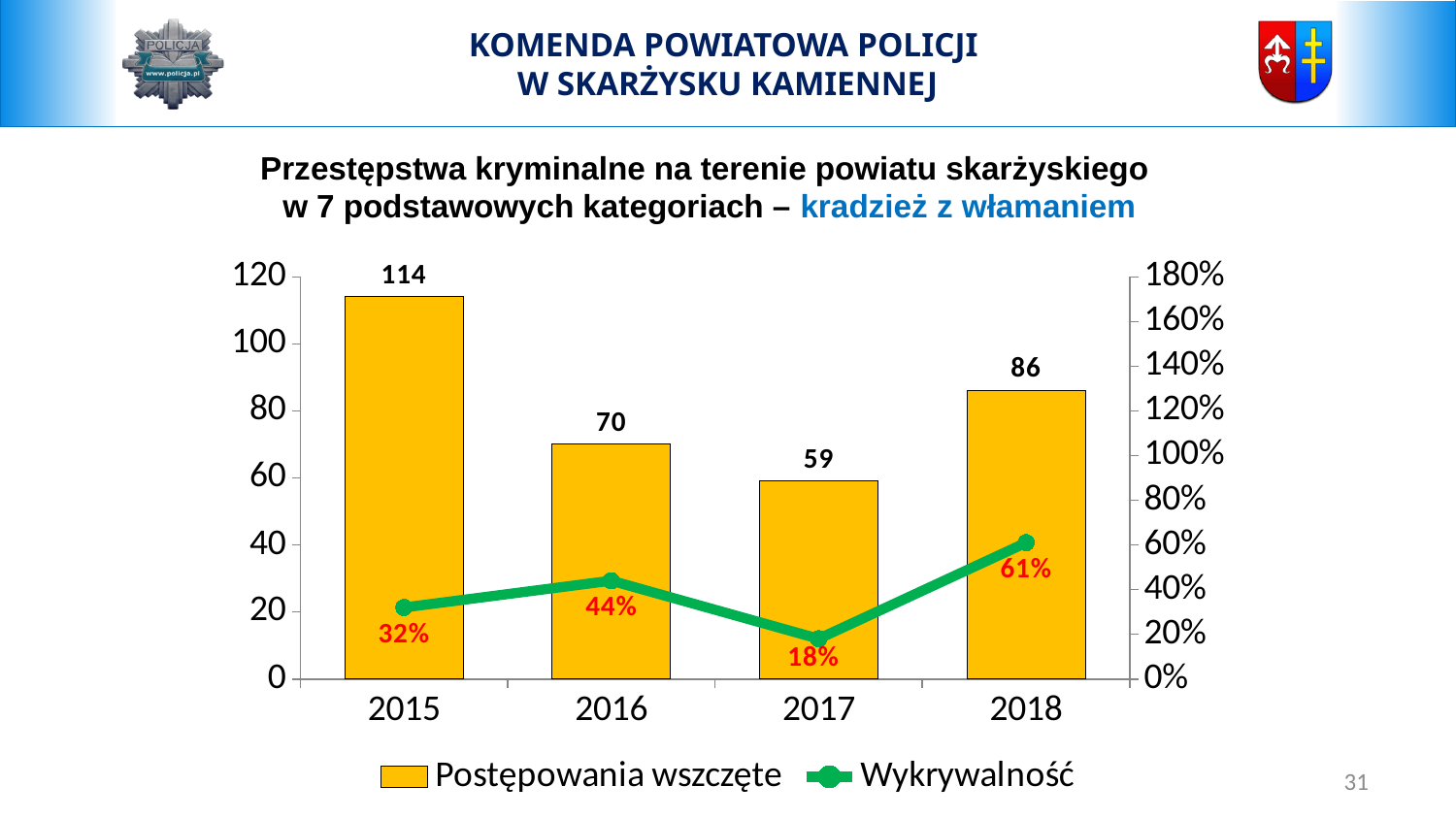
What is the value of Postępowania wszczęte for 2015? 114 What is the difference in Postępowania wszczęte between 2015 and 2016? 44 How many years are shown on the x axis? 4 What colour are the Postępowania wszczęte bars? yellow What kind of chart is used for the Postępowania wszczęte series? bar chart Which year has the highest value of Postępowania wszczęte? 2015 Did Postępowania wszczęte rise or fall from 2017 to 2018? rise Which year has the lowest Wykrywalność? 2017 How many series does the legend list? 2 Which year has the higher Wykrywalność, 2016 or 2018? 2018 What is the value of Postępowania wszczęte for 2018? 86 What is the Wykrywalność value for 2017? 18%